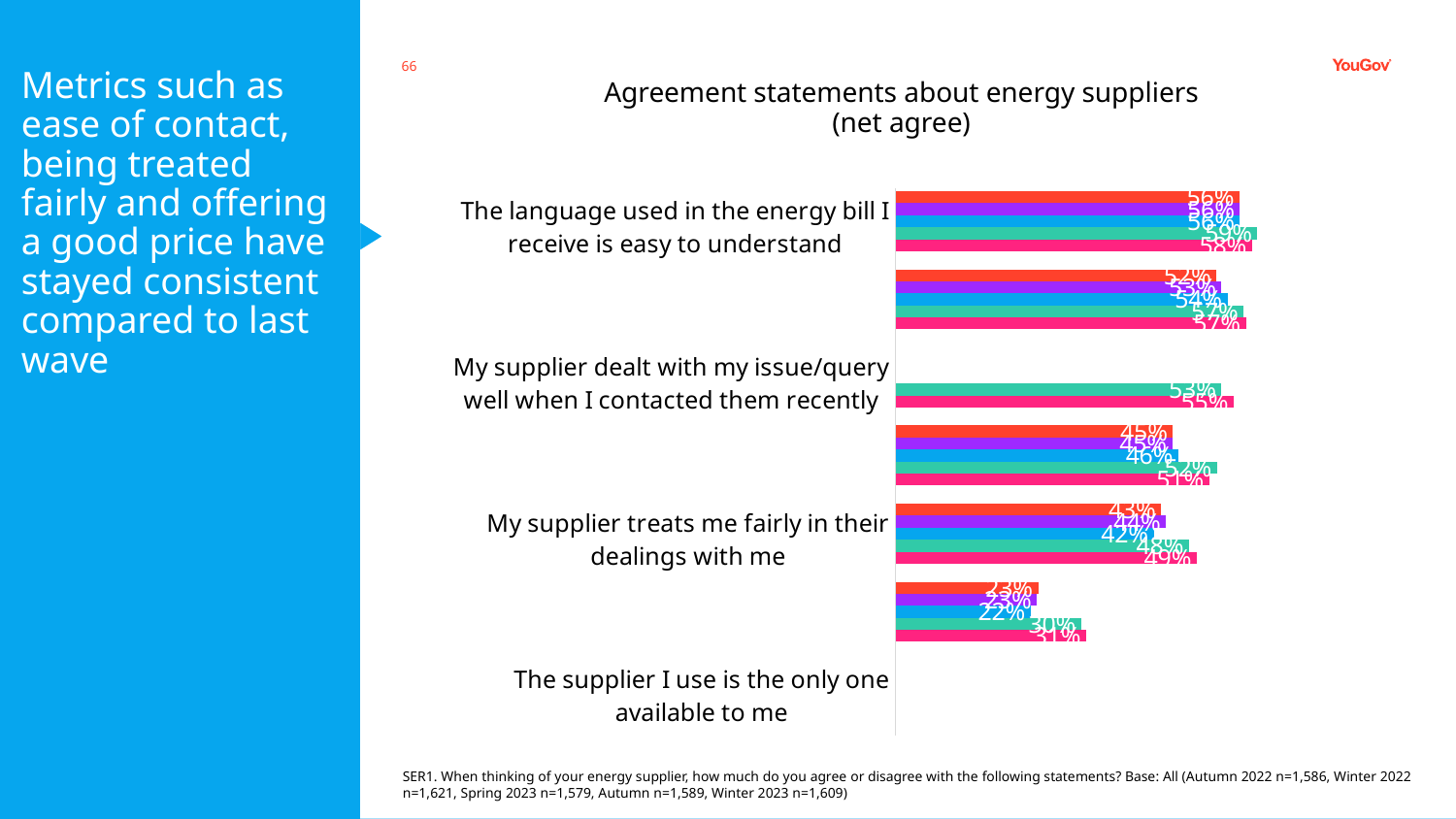
What is the title of the chart? Agreement statements about energy suppliers (net agree) What are the two values shown for 'My supplier dealt with my issue/query well when I contacted them recently'? 53% and 55% How many bars are plotted for the statement 'My supplier dealt with my issue/query well when I contacted them recently'? 2 What survey question code is cited in the footnote of the chart? SER1 What kind of chart is shown on the slide? Bar chart How many agreement statements are listed on the chart? 4 Which statement has the highest net agreement values? The language used in the energy bill I receive is easy to understand